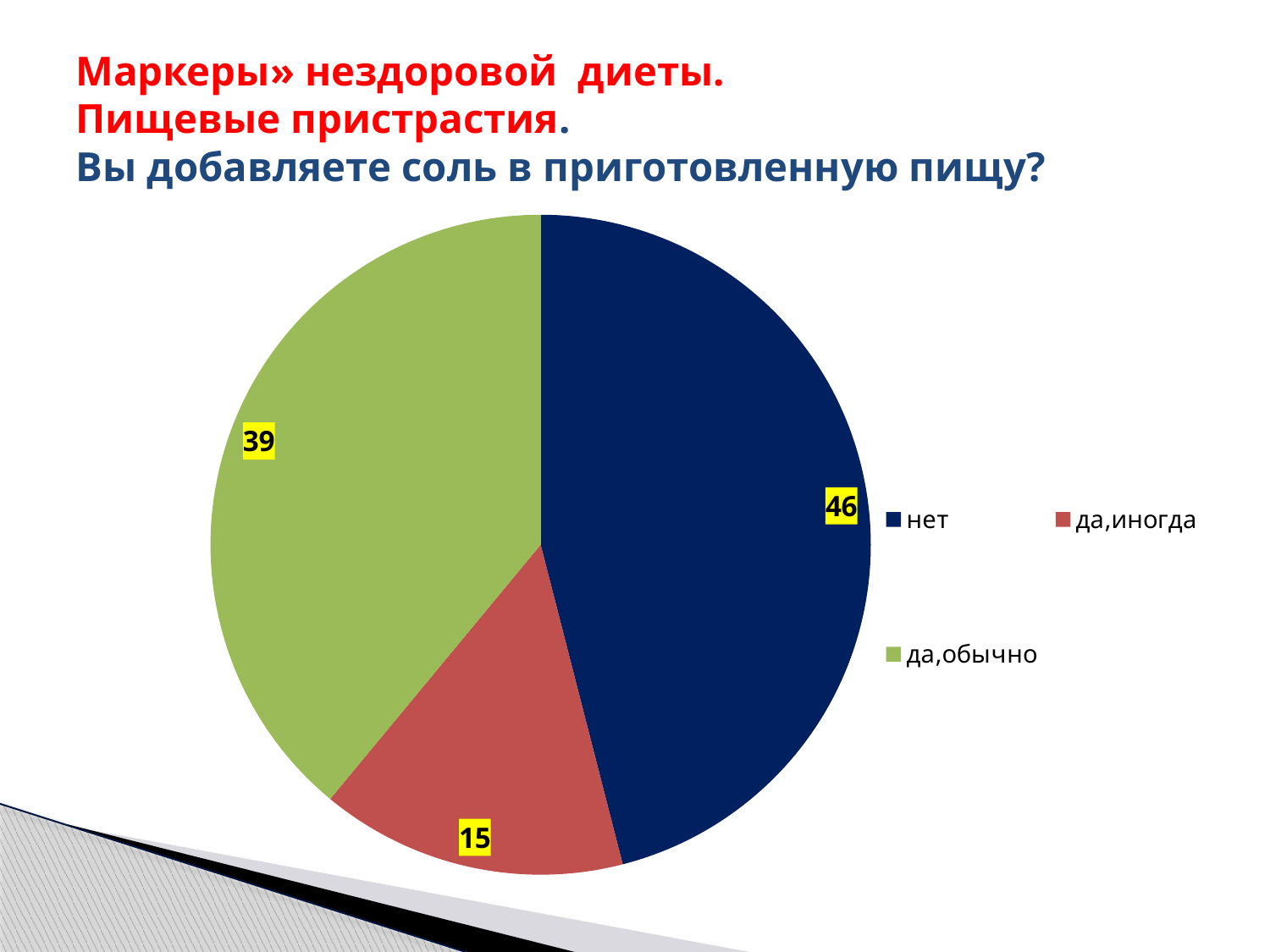
What kind of chart is shown on the slide? pie chart What share of the pie does the "нет" slice represent? 46% What is the difference between the values for "да,обычно" and "да,иногда"? 24 Which category has the largest slice of the pie? нет What colour is the "да,обычно" slice? green What value is shown for the "нет" slice? 46 Which is larger, the value for "да,обычно" or the value for "да,иногда"? да,обычно What is the difference between the values for "нет" and "да,обычно"? 7 Which category has the smallest slice of the pie? да,иногда What value is shown for the "да,обычно" slice? 39 What value is shown for the "да,иногда" slice? 15 How many slices does the pie chart have? 3